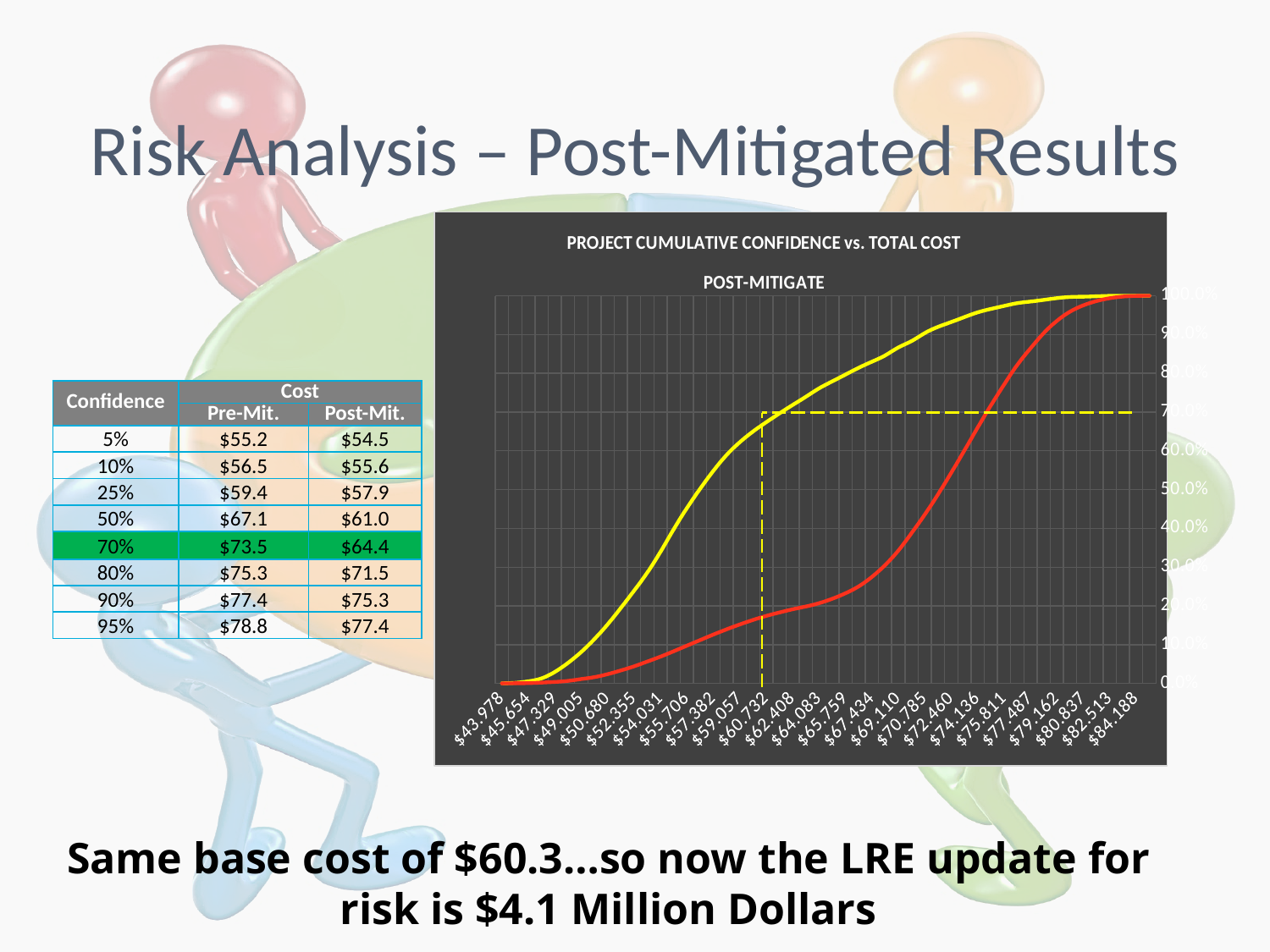
Is the value of the red line at $55,706 greater or less than 20.0%? less Is the value of the yellow line at $50,680 greater or less than 20.0%? less Is the value of the yellow line at $64,083 greater or less than 70.0%? greater What is the title of the chart? PROJECT CUMULATIVE CONFIDENCE vs. TOTAL COST What kind of chart is shown on the slide? line chart What subtitle appears below the chart title? POST-MITIGATE At which confidence level does the horizontal dashed line sit on the chart? 70.0% At $60,732, which line has the higher value, the yellow line or the red line? yellow line How many cost labels are shown along the x axis of the chart? 25 Do the plotted lines rise or fall as total cost increases along the x axis? rise At which x-axis cost value is the vertical dashed line drawn? $60,732